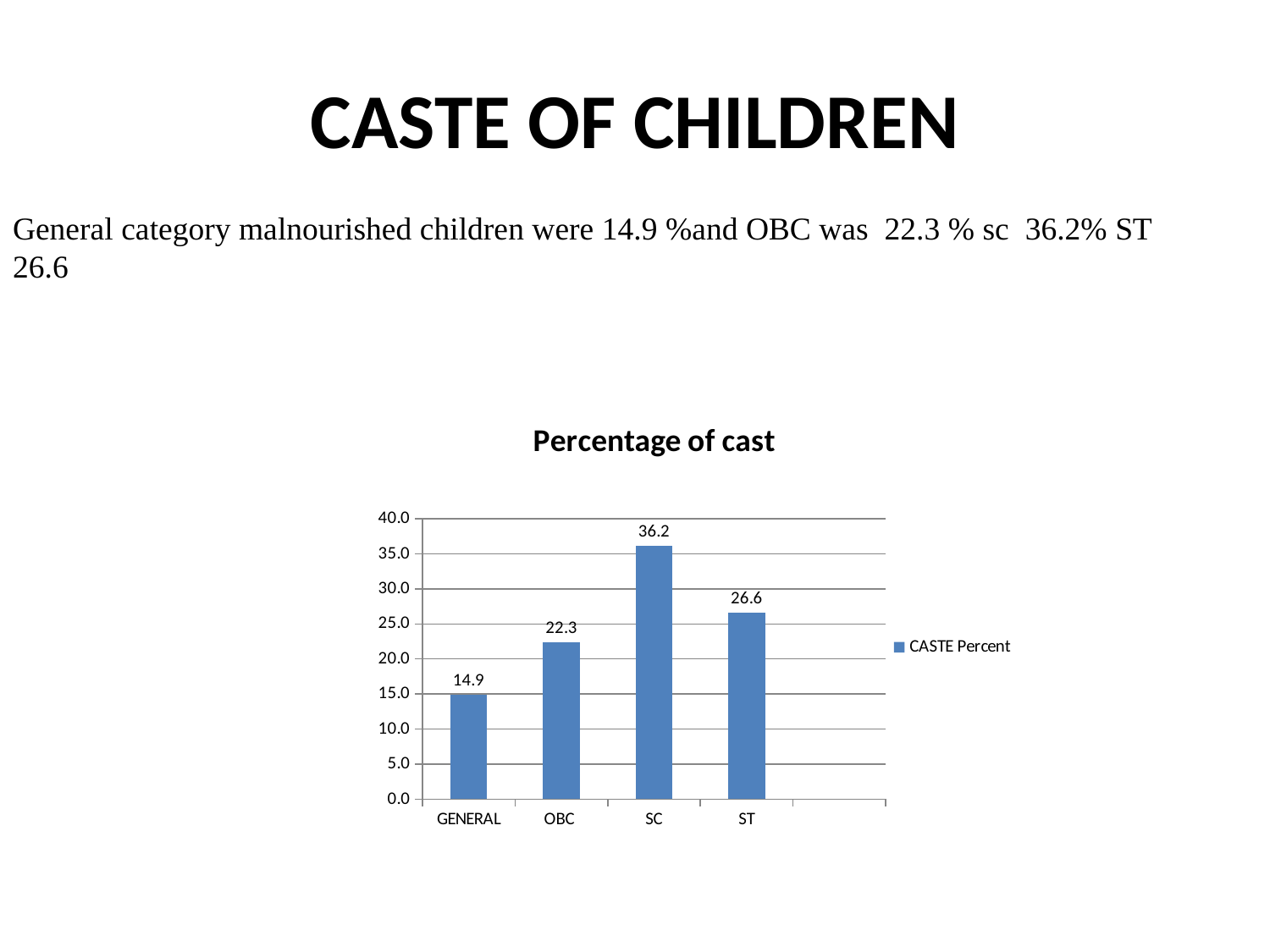
What kind of chart is shown on the slide? Bar chart What is the title of the chart? Percentage of cast How many categories are shown on the x axis? 4 Is the value for OBC greater or less than 20.0? greater What is the value for ST in the chart? 26.6 Which category has the highest value? SC Which category has the lowest value? GENERAL Which is larger, the value for ST or the value for OBC? ST What is the value for GENERAL in the chart? 14.9 What is the value for OBC in the chart? 22.3 What is the value for SC in the chart? 36.2 What is the difference between the values for SC and GENERAL? 21.3